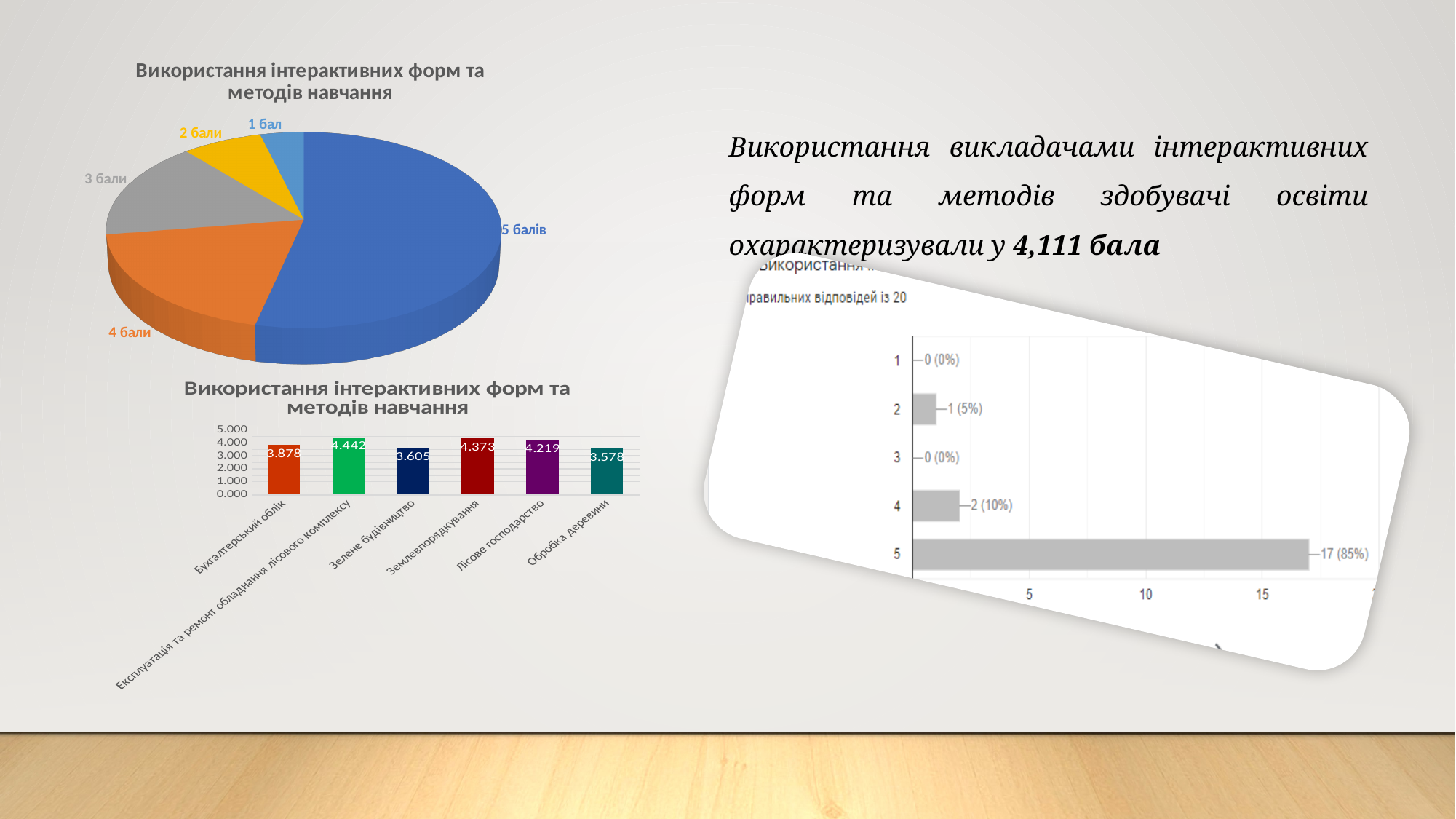
How many categories are shown in the bar chart at the bottom left? 6 What kind of chart is the top-left chart titled 'Використання інтерактивних форм та методів навчання'? Pie chart In the bar chart at the bottom left, which category has the highest value? Експлуатація та ремонт обладнання лісового комплексу In the bar chart at the bottom left, which is larger: the value for Лісове господарство or the value for Бухгалтерський облік? Лісове господарство In the bar chart at the bottom left, what is the value for Обробка деревини? 3.578 In the horizontal bar chart on the right, what is the value for category 5? 17 (85%) In the pie chart at the top left, which category has the largest slice? 5 балів How many slices does the pie chart at the top left have? 5 In the bar chart at the bottom left, which category has the lowest value? Обробка деревини In the horizontal bar chart on the right, what is the value for category 4? 2 (10%) In the bar chart at the bottom left, what is the difference between the values for Землевпорядкування and Зелене будівництво? 0.768 In the bar chart at the bottom left, what is the value for Бухгалтерський облік? 3.878